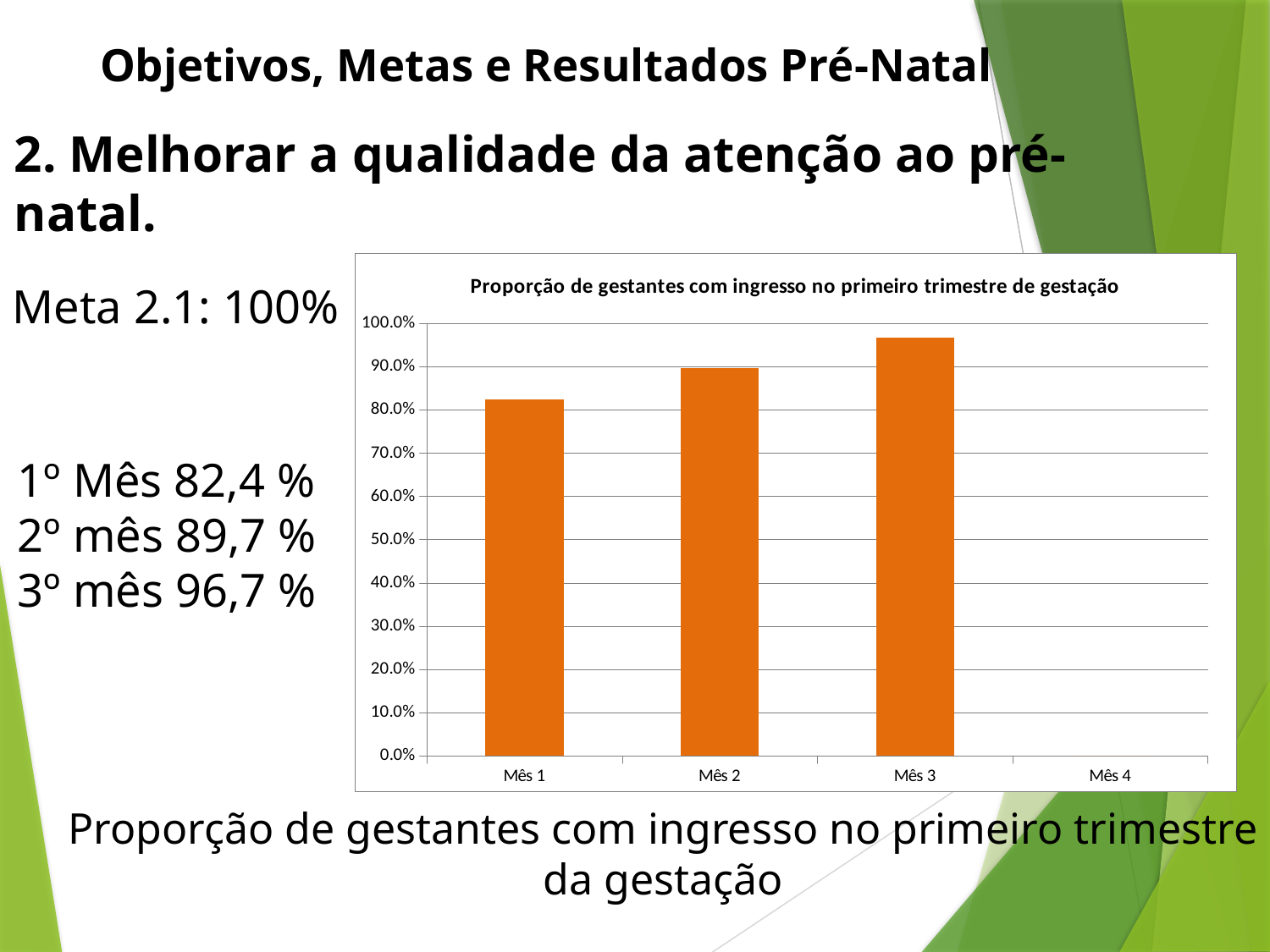
How many category labels appear on the x axis of the chart? 4 Which month has the highest bar in the chart? Mês 3 Do the bar values rise or fall from Mês 1 to Mês 3? rise Which month has the lowest bar in the chart? Mês 1 What is the title of the chart? Proporção de gestantes com ingresso no primeiro trimestre de gestação How many bars are plotted in the chart? 3 Is the value for Mês 1 greater or less than 80.0%? greater Is the value for Mês 3 greater or less than 90.0%? greater What kind of chart is shown on the slide? bar chart Which is larger, the value for Mês 2 or the value for Mês 3? Mês 3 According to the slide text, what is the proportion for the 1º Mês? 82,4 %